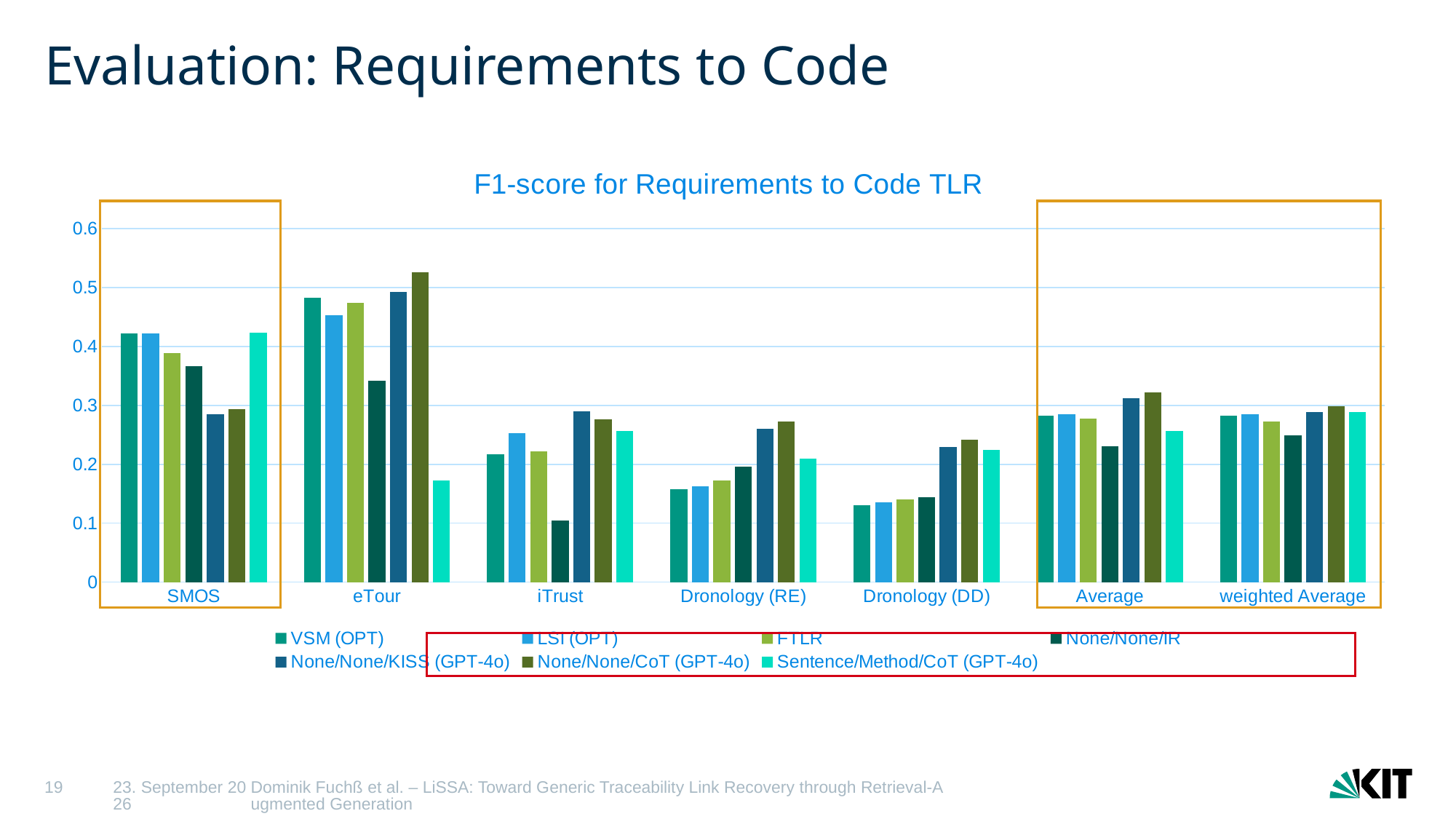
Is the F1-score for None/None/CoT (GPT-4o) in the Average category greater or less than 0.3? greater What kind of chart is shown on the slide? bar chart Is the F1-score for Sentence/Method/CoT (GPT-4o) on eTour greater or less than 0.2? less What is the title of the chart? F1-score for Requirements to Code TLR How many series does the legend list? 7 Is the F1-score for None/None/KISS (GPT-4o) on SMOS greater or less than 0.3? less How many categories are shown along the x axis of the chart? 7 For iTrust, which is larger: the F1-score of None/None/IR or of None/None/KISS (GPT-4o)? None/None/KISS (GPT-4o) For Dronology (RE), which is larger: the F1-score of VSM (OPT) or of None/None/CoT (GPT-4o)? None/None/CoT (GPT-4o) For iTrust, which series has the lowest F1-score? None/None/IR For eTour, which series has the highest F1-score? None/None/CoT (GPT-4o)